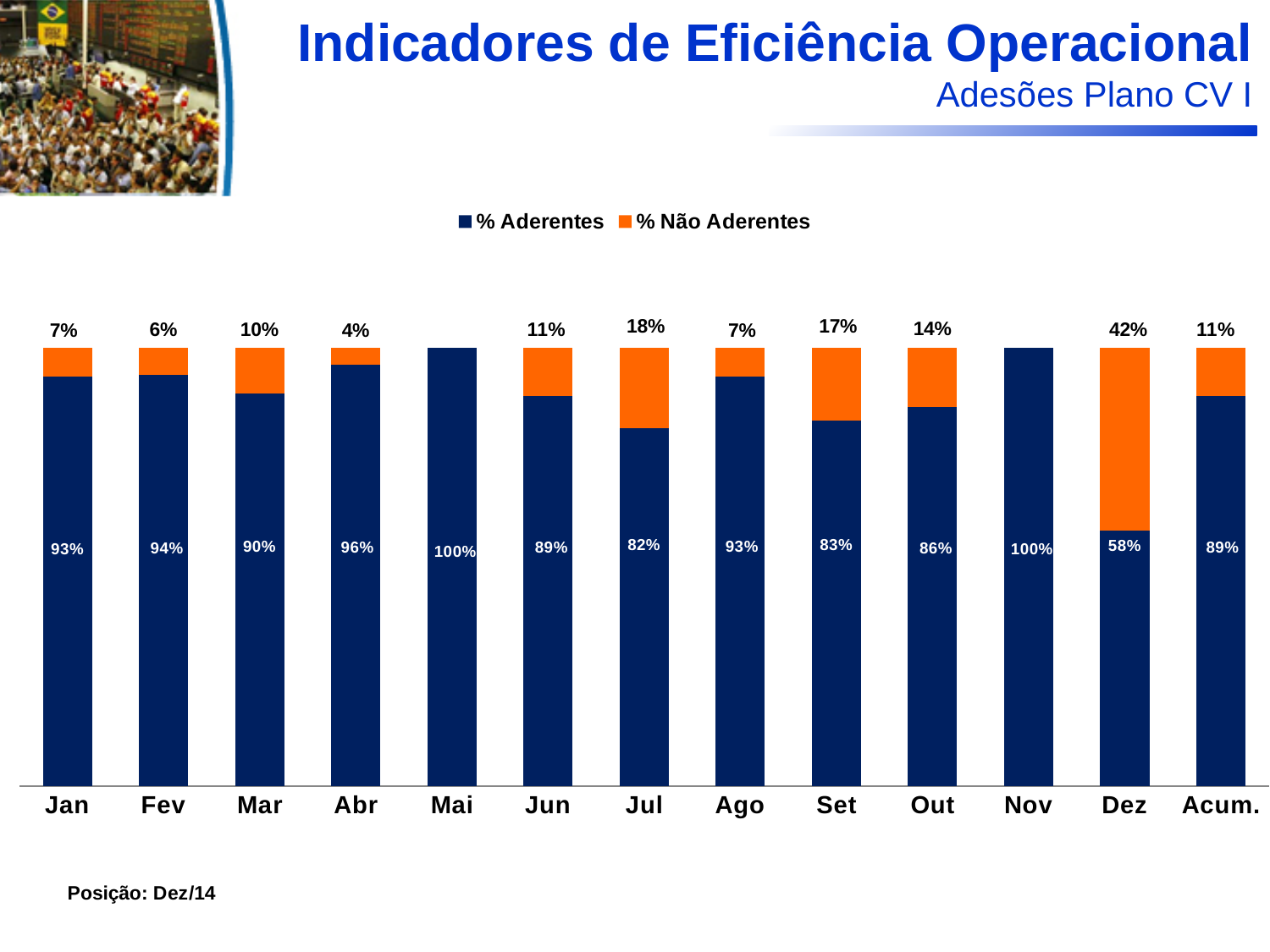
What is the % Aderentes value for Dez? 58% Which category has the highest % Não Aderentes value? Dez What is the % Aderentes value for Acum.? 89% Which month has the lowest % Aderentes value? Dez Which months show a % Aderentes value of 100%? Mai and Nov What kind of chart is shown on the slide? Stacked bar chart How many series does the legend list? 2 What is the % Não Aderentes value for Jul? 18% How many categories are shown on the x axis? 13 Which is larger, the % Não Aderentes value for Set or for Out? Set Which colour represents the % Não Aderentes series? Orange What is the difference between the % Aderentes values for Abr and Jul? 14%